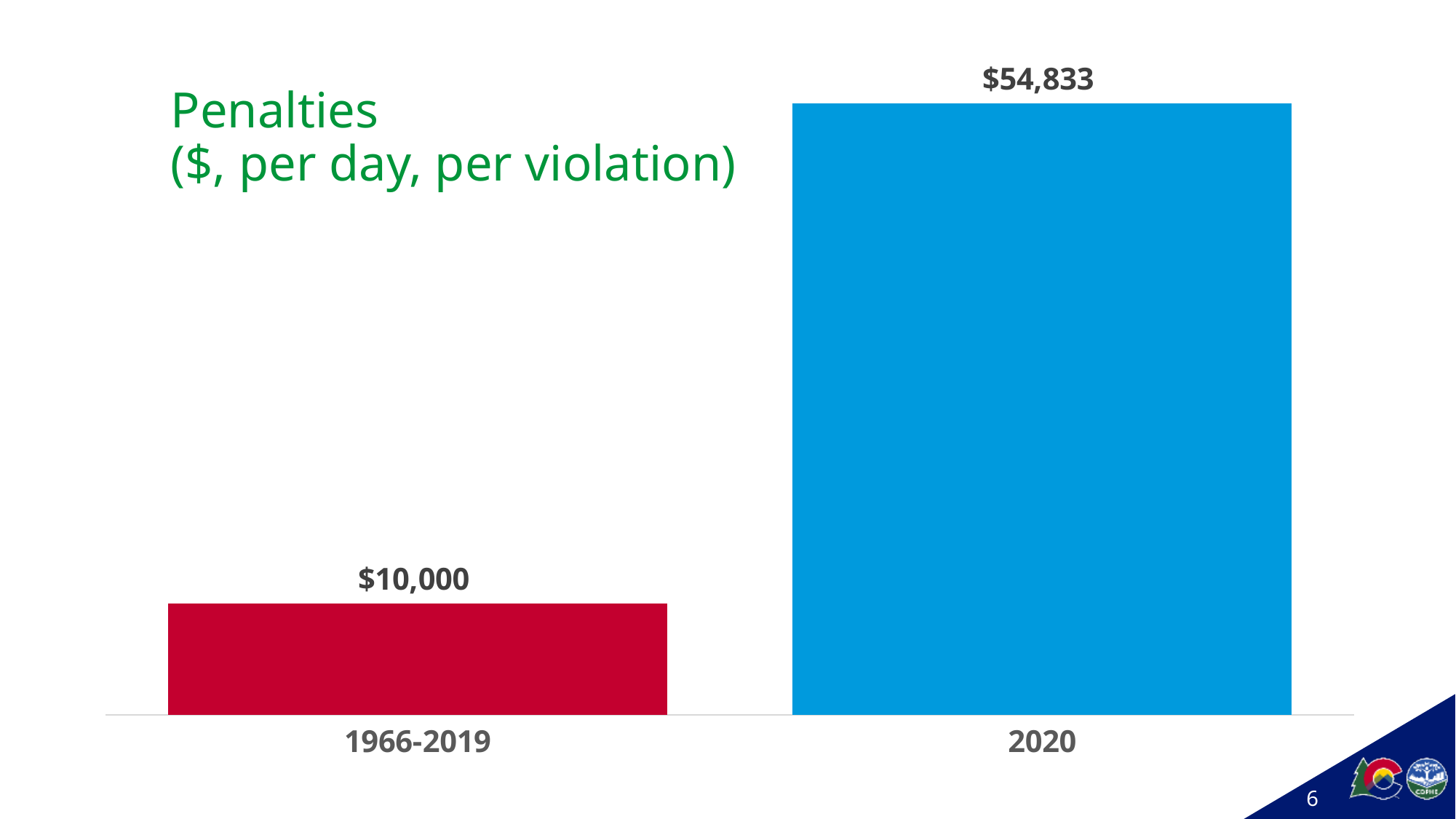
Which is larger, the penalty for 1966-2019 or for 2020? 2020 Do the penalty values rise or fall from 1966-2019 to 2020? Rise What is the penalty value shown for 2020? $54,833 Which category has the highest penalty value? 2020 What kind of chart is shown on the slide? Bar chart Which category has the lowest penalty value? 1966-2019 What is the title of the chart? Penalties ($, per day, per violation) What is the penalty value shown for 1966-2019? $10,000 What is the difference between the 2020 penalty and the 1966-2019 penalty? $44,833 How many categories are shown on the x axis? 2 What colour is the bar for 2020? Blue